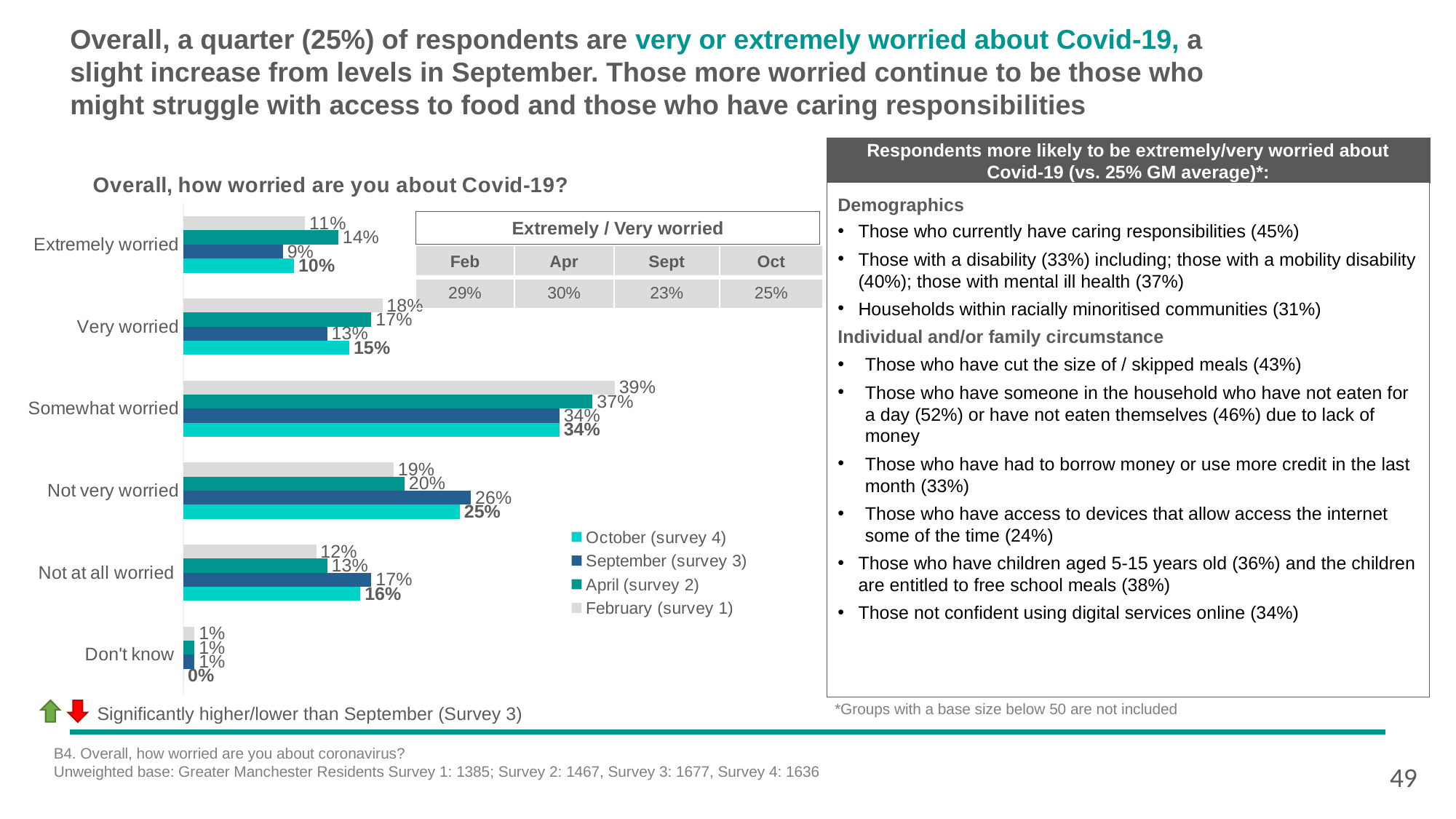
What is the April (survey 2) value for 'Not at all worried'? 13% What is the October (survey 4) value for 'Somewhat worried'? 34% How many series does the legend of the 'Overall, how worried are you about Covid-19?' chart list? 4 Which is larger for 'Extremely worried': the April (survey 2) value or the September (survey 3) value? April (survey 2) What is the difference between the September (survey 3) and October (survey 4) values for 'Very worried'? 2% What is the September (survey 3) value for 'Not very worried'? 26% Which response category has the lowest February (survey 1) value? Don't know What is the February (survey 1) value for 'Extremely worried'? 11% How many response categories are shown on the 'Overall, how worried are you about Covid-19?' chart? 6 Which response category has the highest October (survey 4) value? Somewhat worried What kind of chart is used to show responses to 'Overall, how worried are you about Covid-19?' Bar chart In the 'Extremely / Very worried' table, what is the value for Sept? 23%